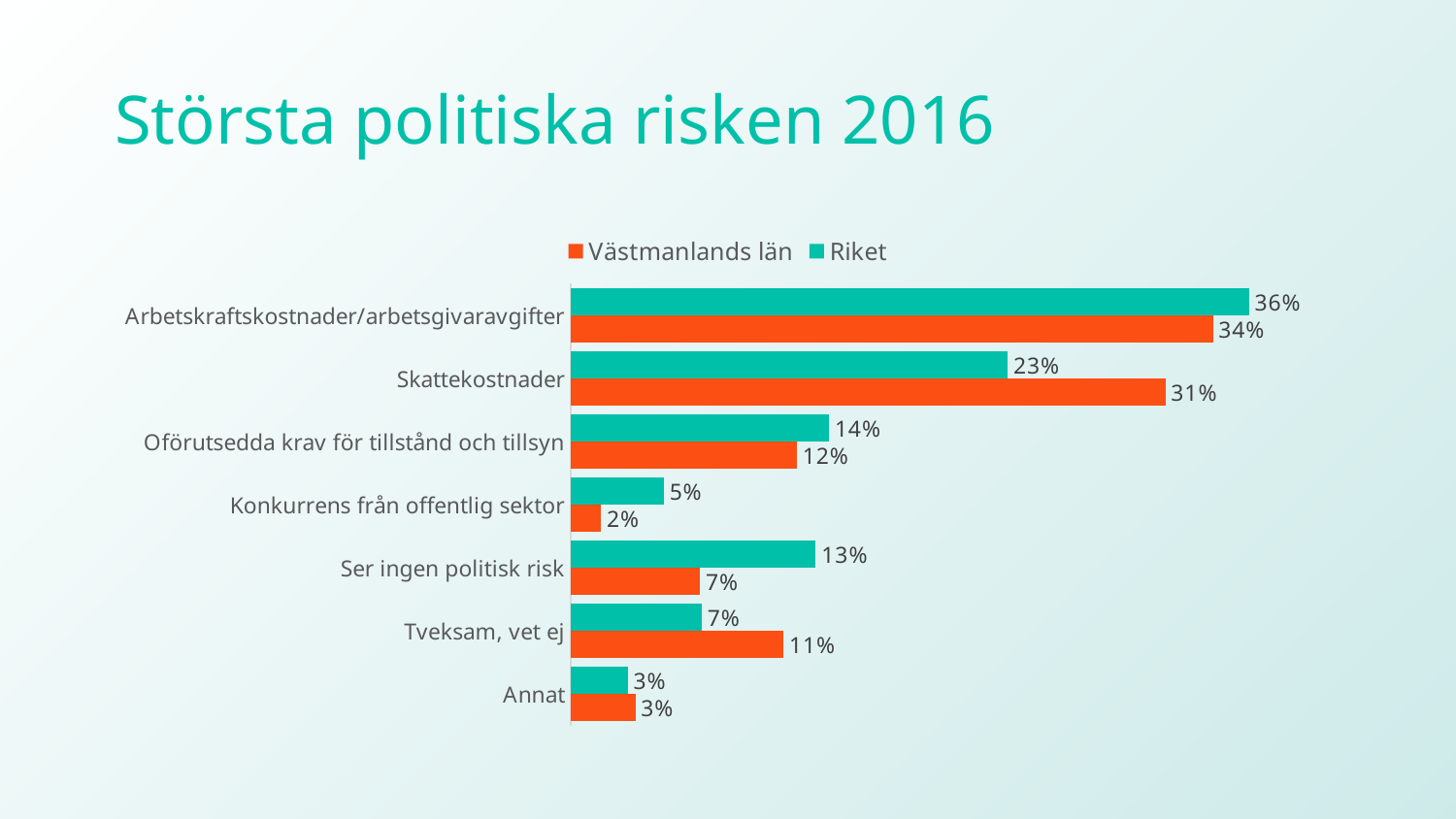
Which category has the highest value for Västmanlands län? Arbetskraftskostnader/arbetsgivaravgifter What is the value for Västmanlands län for Tveksam, vet ej? 11% What is the value for Västmanlands län for Skattekostnader? 31% Which category has the lowest value for Västmanlands län? Konkurrens från offentlig sektor How many categories are shown on the chart? 7 How many series does the legend list? 2 What is the title of the slide? Största politiska risken 2016 What is the value for Riket for Arbetskraftskostnader/arbetsgivaravgifter? 36% What is the difference between the Riket and Västmanlands län values for Skattekostnader? 8% Which is larger for Ser ingen politisk risk: Västmanlands län or Riket? Riket What is the value for Riket for Ser ingen politisk risk? 13% What kind of chart is shown on the slide? Bar chart